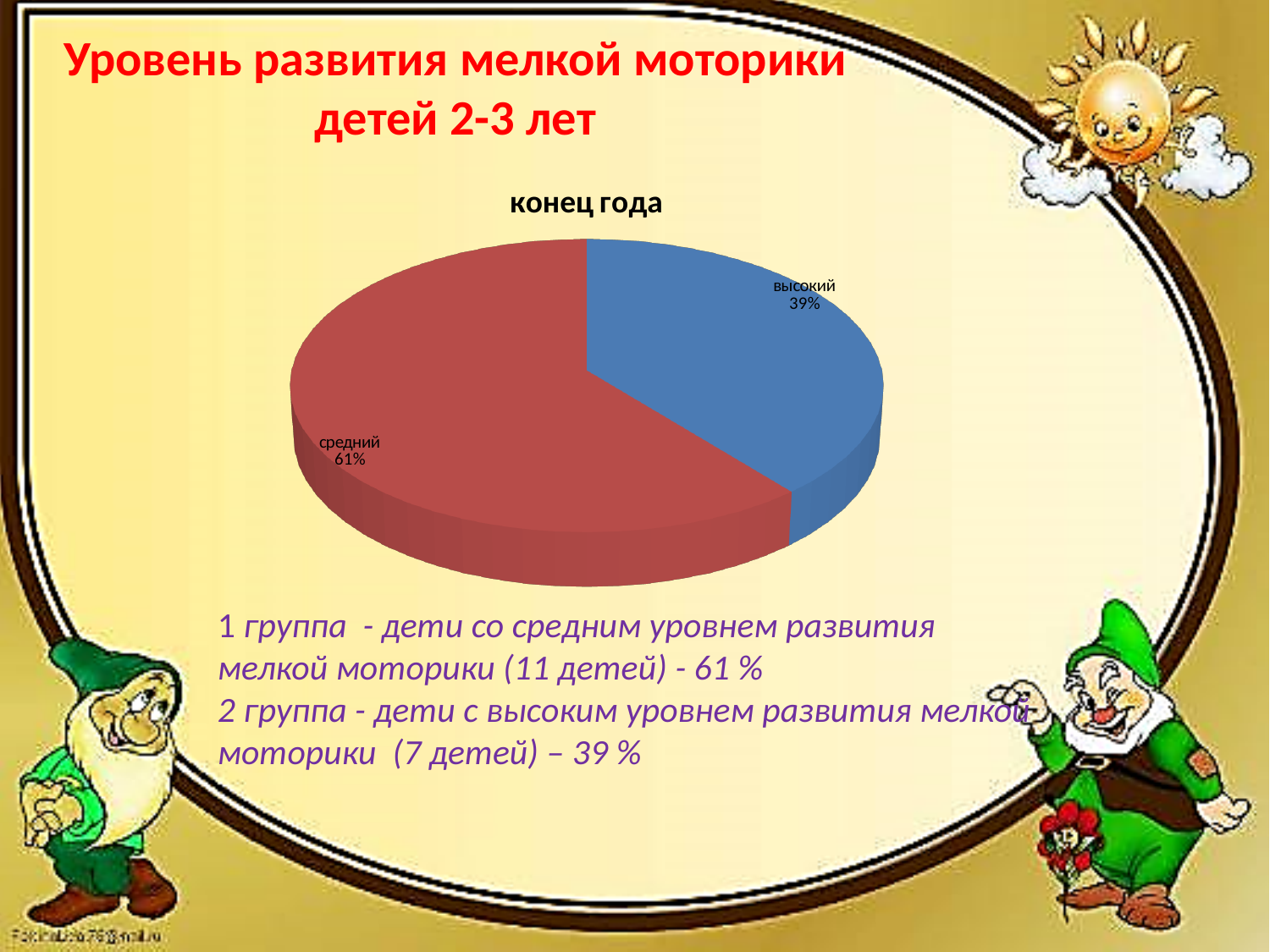
What is the difference in percentage points between the 'средний' and 'высокий' slices? 22 What share of the pie does the 'высокий' slice take? 39% What colour is the 'средний' slice? red Which is larger, the 'средний' slice or the 'высокий' slice? средний What kind of chart is shown on the slide? pie chart Which slice is the smallest? высокий What is the chart's title? конец года Which slice is the largest? средний What percentage does the 'высокий' slice show? 39% What percentage does the 'средний' slice show? 61% How many slices does the pie chart have? 2